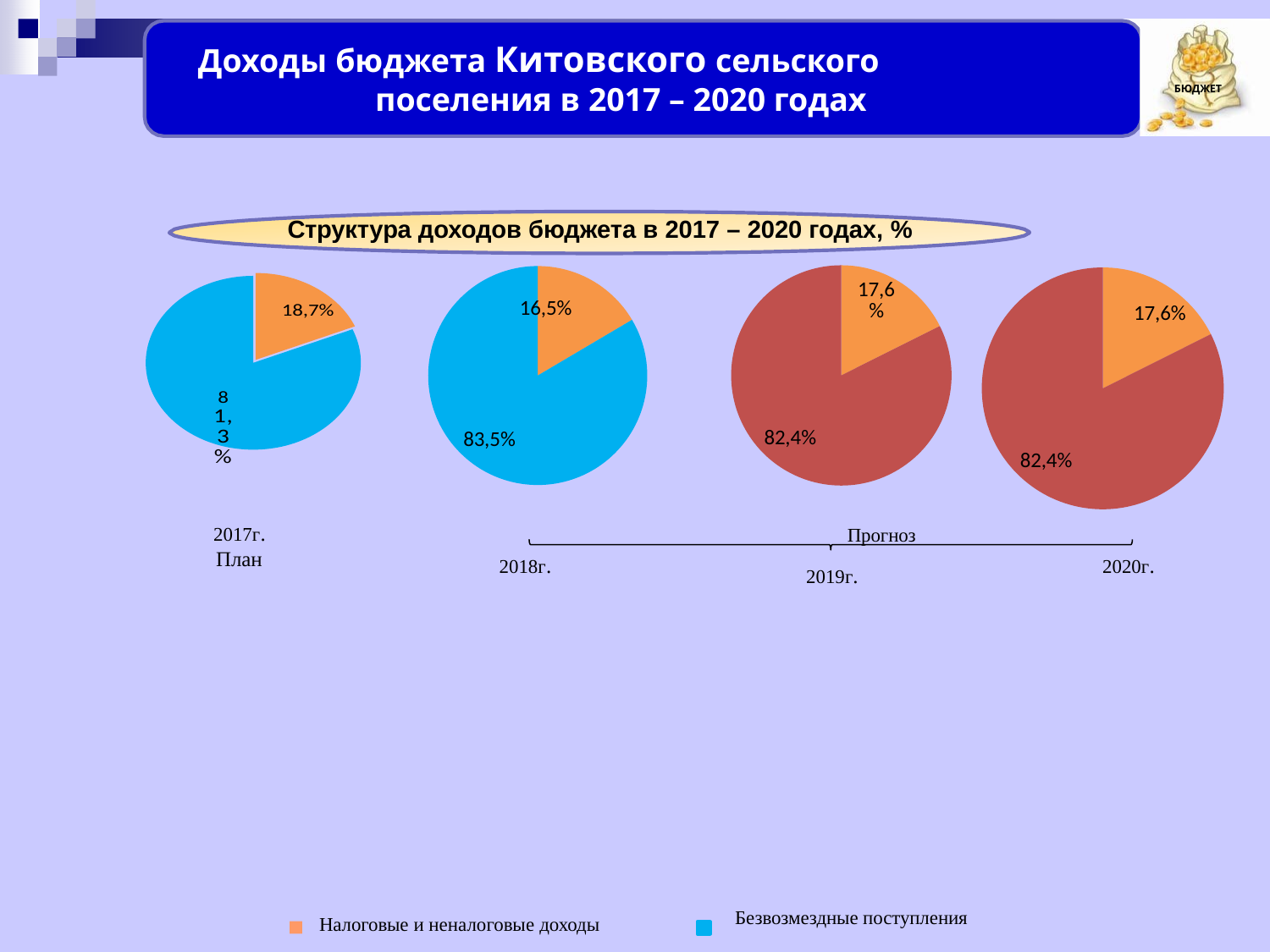
In the 2017г. План pie chart, what share is shown for Налоговые и неналоговые доходы (orange slice)? 18,7% How many pie charts are shown on the slide? 4 In the 2018г. pie chart, what share is shown for Безвозмездные поступления (blue slice)? 83,5% What is the difference between the orange slice share in the 2017г. План pie chart (18,7%) and in the 2018г. pie chart (16,5%)? 2,2% In the 2017г. План pie chart, what share is shown for Безвозмездные поступления (blue slice)? 81,3% Which year's pie chart shows the smallest share for Налоговые и неналоговые доходы (orange slice)? 2018г. In the 2019г. pie chart, what share is shown for the orange slice (Налоговые и неналоговые доходы)? 17,6% In the 2018г. pie chart, what share is shown for Налоговые и неналоговые доходы (orange slice)? 16,5% In the 2020г. pie chart, what share is shown for the larger slice? 82,4% How many entries does the legend at the bottom of the slide list? 2 What kind of chart is used to show the budget revenue structure for each year on the slide? pie chart Which year's pie chart shows the largest share for Налоговые и неналоговые доходы (orange slice)? 2017г. План